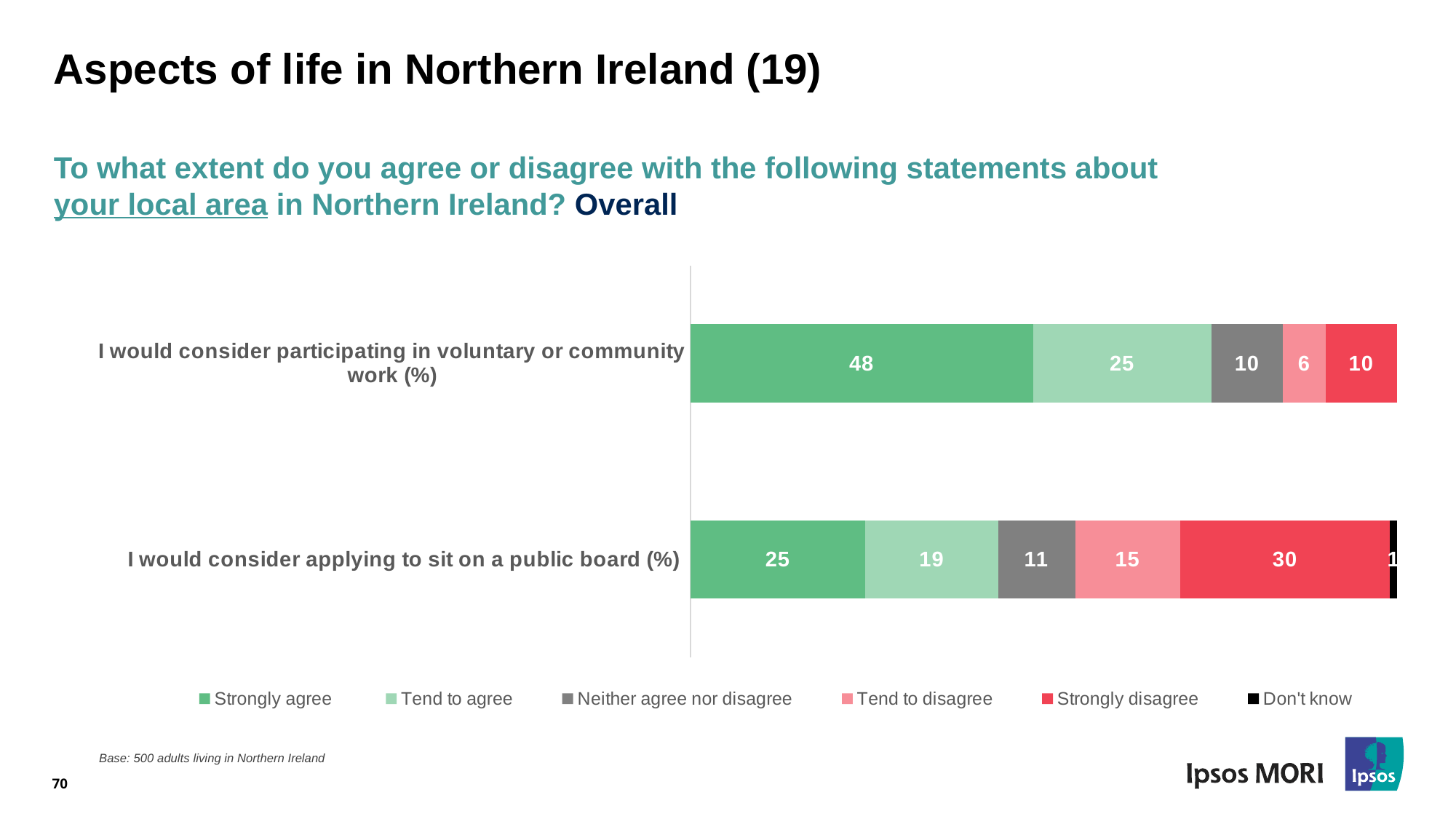
How many statements are shown in the chart? 2 How many series does the legend list? 6 What is the difference between the 'Strongly agree' values for the voluntary or community work statement and the public board statement? 23 Which legend entry is shown in black? Don't know What kind of chart is shown on the slide? Stacked bar chart Which statement has the higher 'Strongly agree' value? I would consider participating in voluntary or community work (%) Which statement has the larger 'Strongly disagree' value? I would consider applying to sit on a public board (%) What percentage strongly disagree that they would consider applying to sit on a public board? 30 What percentage tend to agree that they would consider applying to sit on a public board? 19 What percentage tend to disagree that they would consider participating in voluntary or community work? 6 What is the combined 'Strongly agree' and 'Tend to agree' value for the voluntary or community work statement? 73 What percentage strongly agree that they would consider participating in voluntary or community work? 48